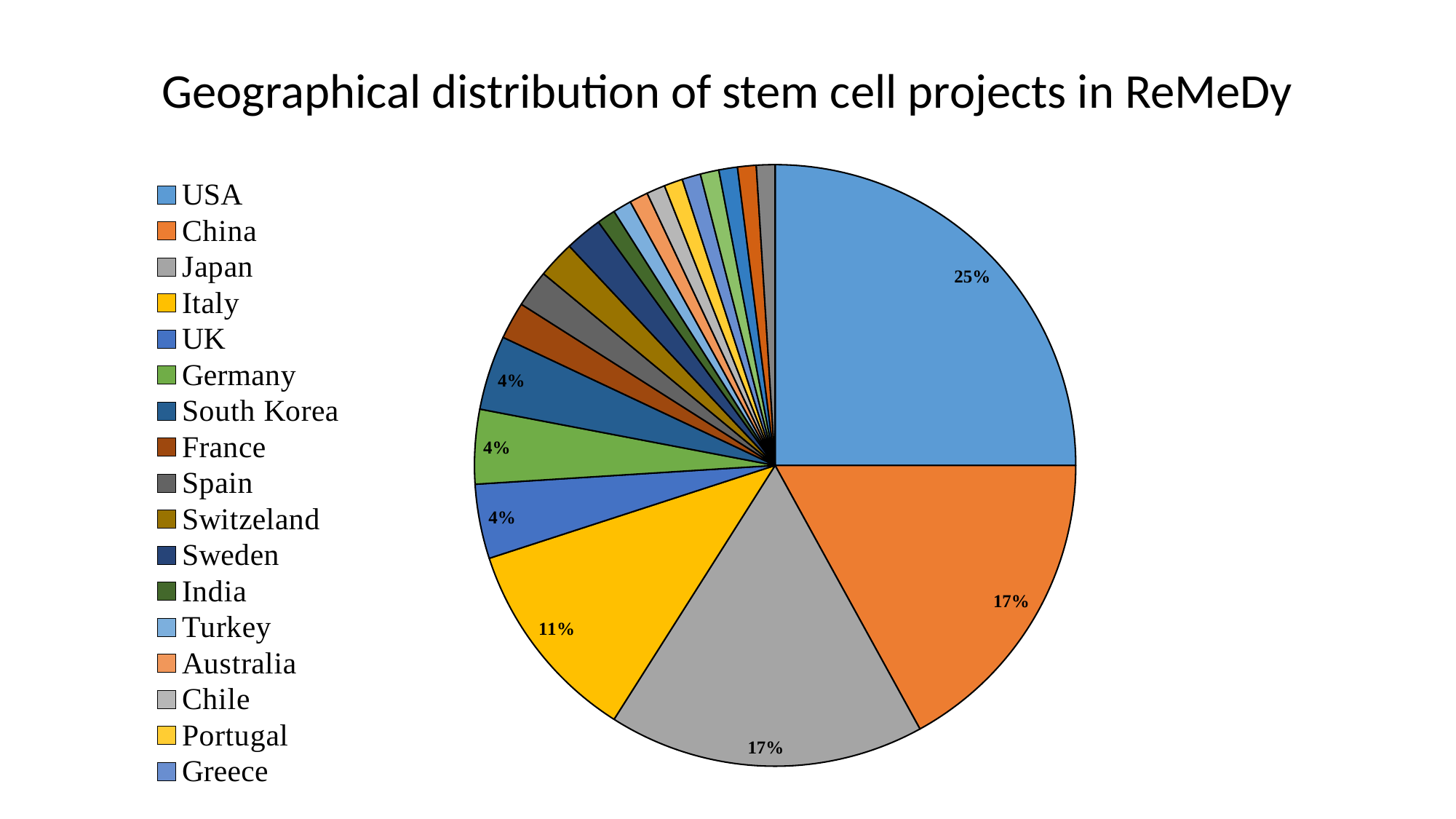
What share of the pie does Italy have? 11% What kind of chart is shown on the slide? pie chart Which country has the largest share of stem cell projects? USA Which has a larger share, the USA or China? USA What share of stem cell projects does the USA account for? 25% Which has a larger share, Italy or the UK? Italy How many percentage points larger is the USA share than the Italy share? 14 percentage points How many countries are listed in the legend? 17 What percentage is shown for China? 17% What percentage is shown for Japan? 17% What percentage is labelled for the UK slice? 4% What percentage is labelled for Germany? 4%